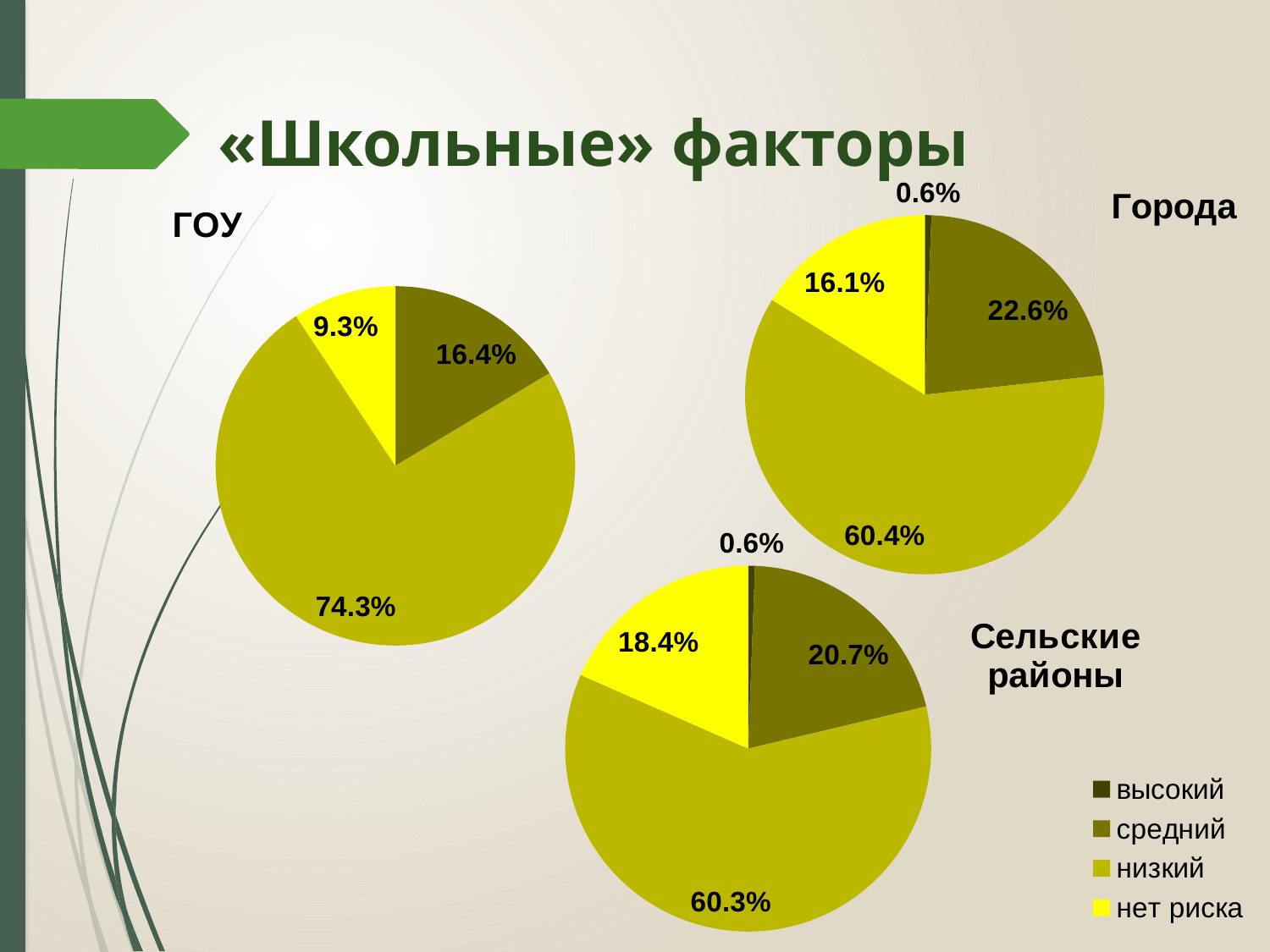
In the ГОУ pie chart, what is the share for низкий? 74.3% In the ГОУ pie chart, which category has the smallest labelled share? нет риска Which is larger: the нет риска share in the Сельские районы chart or in the Города chart? Сельские районы In the Сельские районы pie chart, which category has the largest share? низкий In the Города pie chart, what is the share for высокий? 0.6% How many entries does the legend list? 4 In the Города pie chart, what is the share for средний? 22.6% What type of charts are shown on the slide? Pie charts In the Сельские районы pie chart, what is the share for нет риска? 18.4% In the Города pie chart, which category has the smallest share? высокий How many pie charts are on the slide? 3 What is the difference between the низкий share in the ГОУ chart and the низкий share in the Города chart? 13.9%